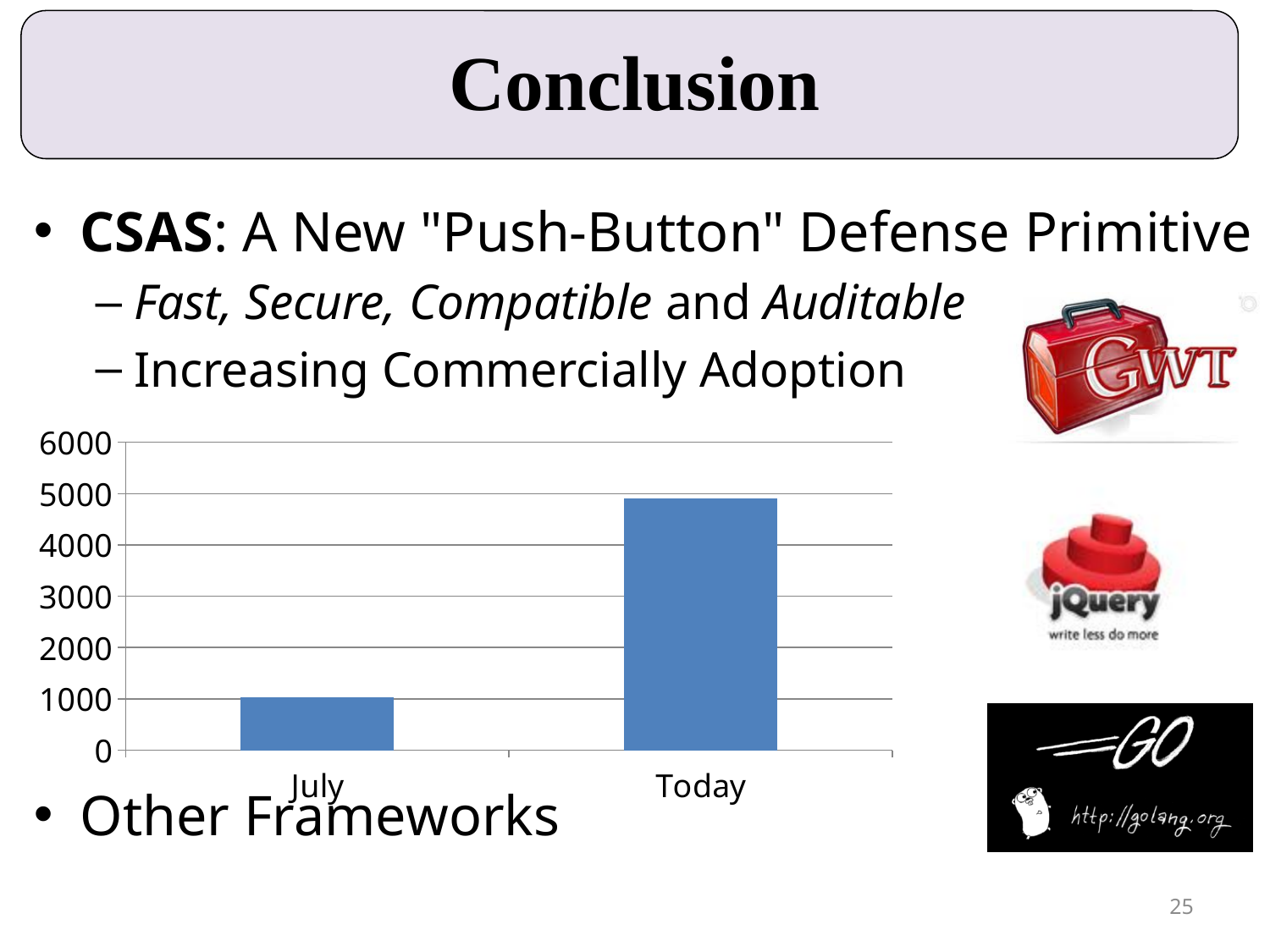
Is the value for July greater or less than 500? greater Is the value for Today greater or less than 3000? greater Which category has the lowest value in the chart? July Do the values rise or fall from July to Today? rise What is the highest value shown on the vertical axis of the chart? 6000 Which is larger, the value for July or the value for Today? Today Which category has the highest value in the chart? Today Is the value for Today greater or less than 4000? greater What kind of chart is shown on the slide? bar chart How many categories are plotted on the x axis of the chart? 2 What are the two category labels on the x axis of the chart? July and Today